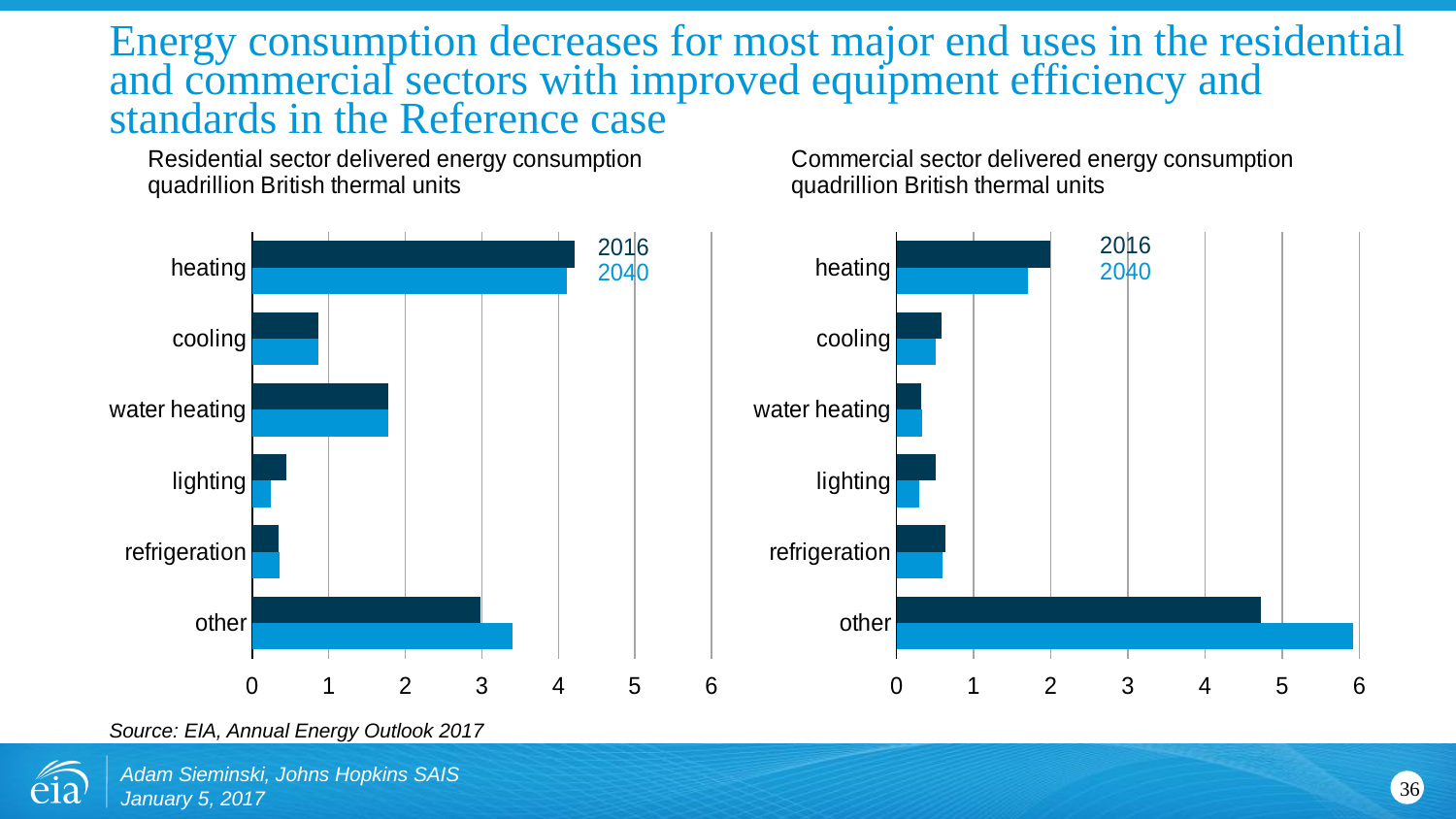
In the Residential sector chart, is lighting consumption larger in 2016 or in 2040? 2016 How many end-use categories are shown in the Residential sector chart? 6 In the Commercial sector chart, is the 2040 value for heating greater or less than 2? less In the Commercial sector chart, is the 2040 value for other greater or less than 5? greater How many series does the legend of the Commercial sector chart list? 2 In the Residential sector chart, is the 2040 value for other greater or less than 3? greater In the Commercial sector chart, which end use has the highest energy consumption in 2040? other In the Residential sector chart, which end use has the lowest energy consumption in 2040? lighting In the Commercial sector chart, is consumption for other larger in 2016 or in 2040? 2040 What kind of chart is the Residential sector delivered energy consumption chart? bar chart In the Residential sector chart, which end use has the highest energy consumption in 2016? heating